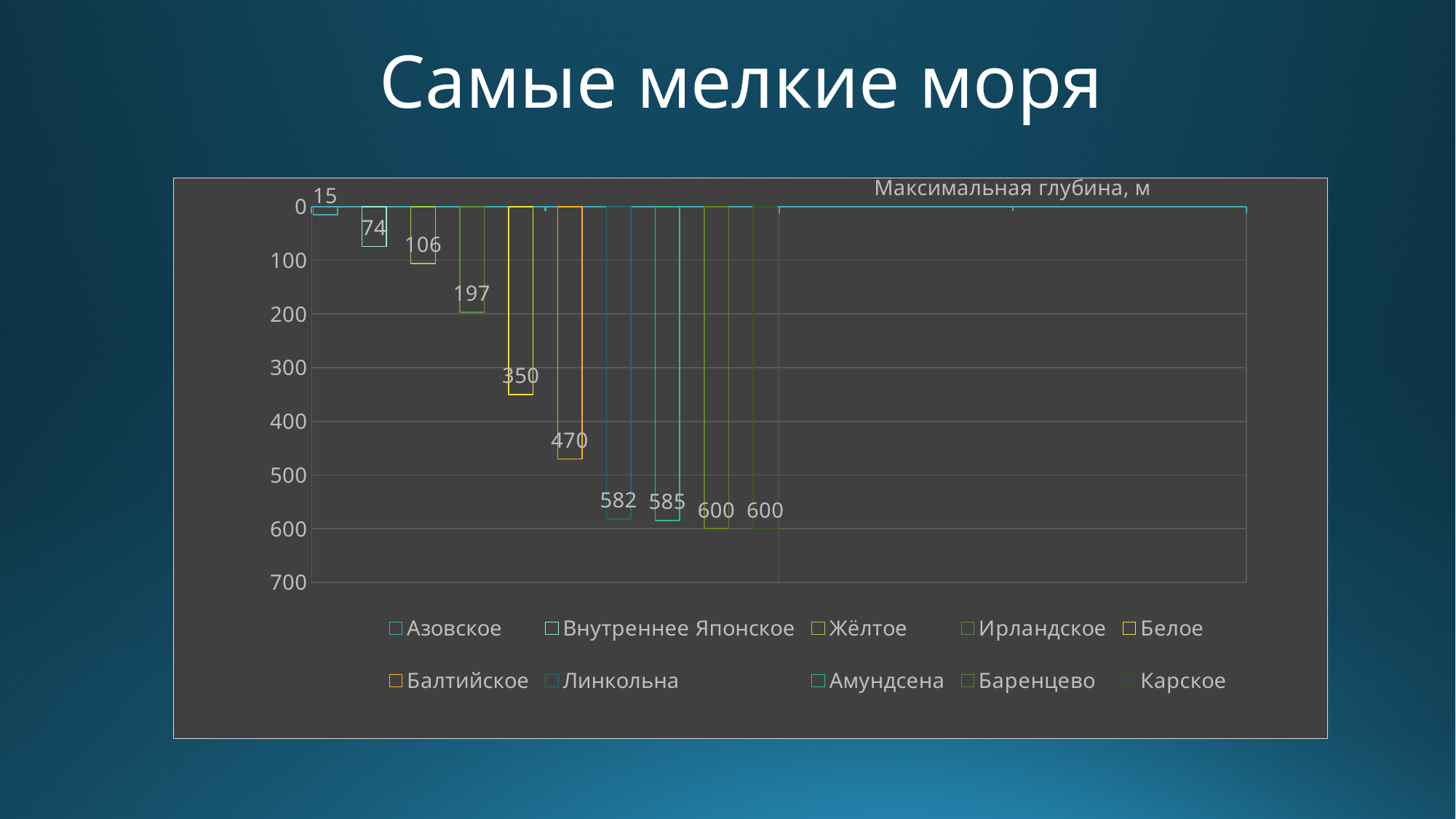
What kind of chart is shown on the slide? Bar chart Which sea has the smallest maximum depth on the chart? Азовское What is the maximum depth shown for Азовское? 15 What is the title of the chart? Максимальная глубина, м Which has a greater maximum depth, Жёлтое or Внутреннее Японское? Жёлтое What is the maximum depth shown for Балтийское? 470 What is the maximum depth shown for Амундсена? 585 How many series does the legend list? 10 What is the maximum depth shown for Белое? 350 What is the maximum depth shown for Ирландское? 197 What is the maximum depth shown for Линкольна? 582 What is the difference between the maximum depths of Балтийское and Белое? 120